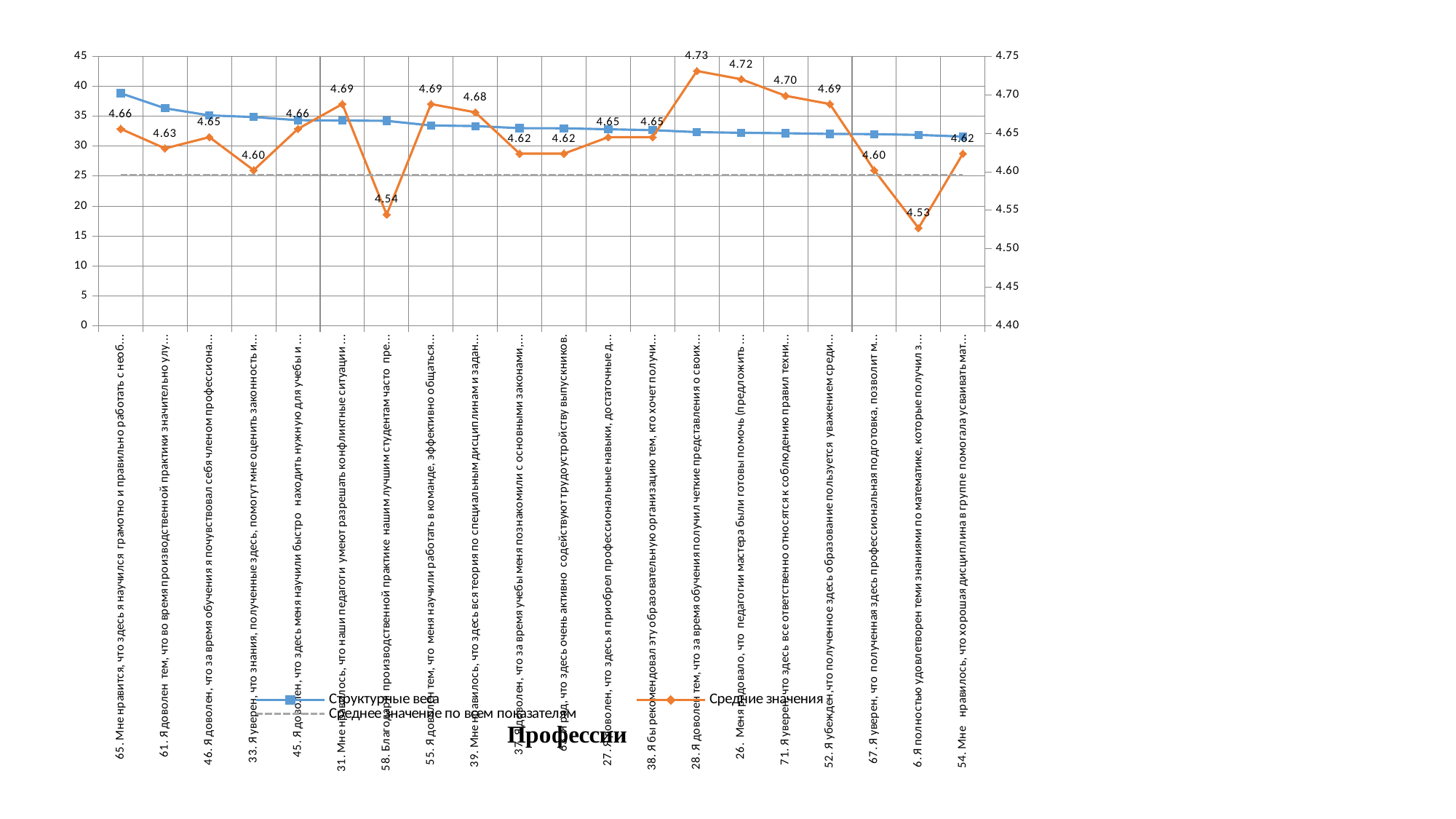
What kind of chart is shown on the slide? line chart What is the difference between the highest and lowest 'Средние значения' values? 0.20 How many series does the legend list? 3 Is the 'Структурные веса' value for the first item (65. Мне нравится, что здесь я научился...) greater or less than 35? greater Is the 'Структурные веса' value for the last item (54. Мне нравилось, что хорошая дисциплина...) greater or less than 35? less What is the value of 'Средние значения' for the item starting '58. Благодаря производственной практике...'? 4.54 How many items (categories) are plotted along the x axis? 20 Which item has the highest 'Средние значения' value? 28. Я доволен тем, что за время обучения получил четкие представления о своих... Which item has the lowest 'Средние значения' value? 6. Я полностью удовлетворен теми знаниями по математике, которые получил з... Does the 'Структурные веса' line rise or fall from left to right along the x axis? fall Which has a larger 'Средние значения' value: the item starting '26. Меня радовало...' or the item starting '71. Я уверен, что здесь все ответственно...'? 26. Меня радовало, что педагогии мастера были готовы помочь... What is the value of 'Средние значения' for the item starting '28. Я доволен тем, что за время обучения получил четкие представления...'? 4.73